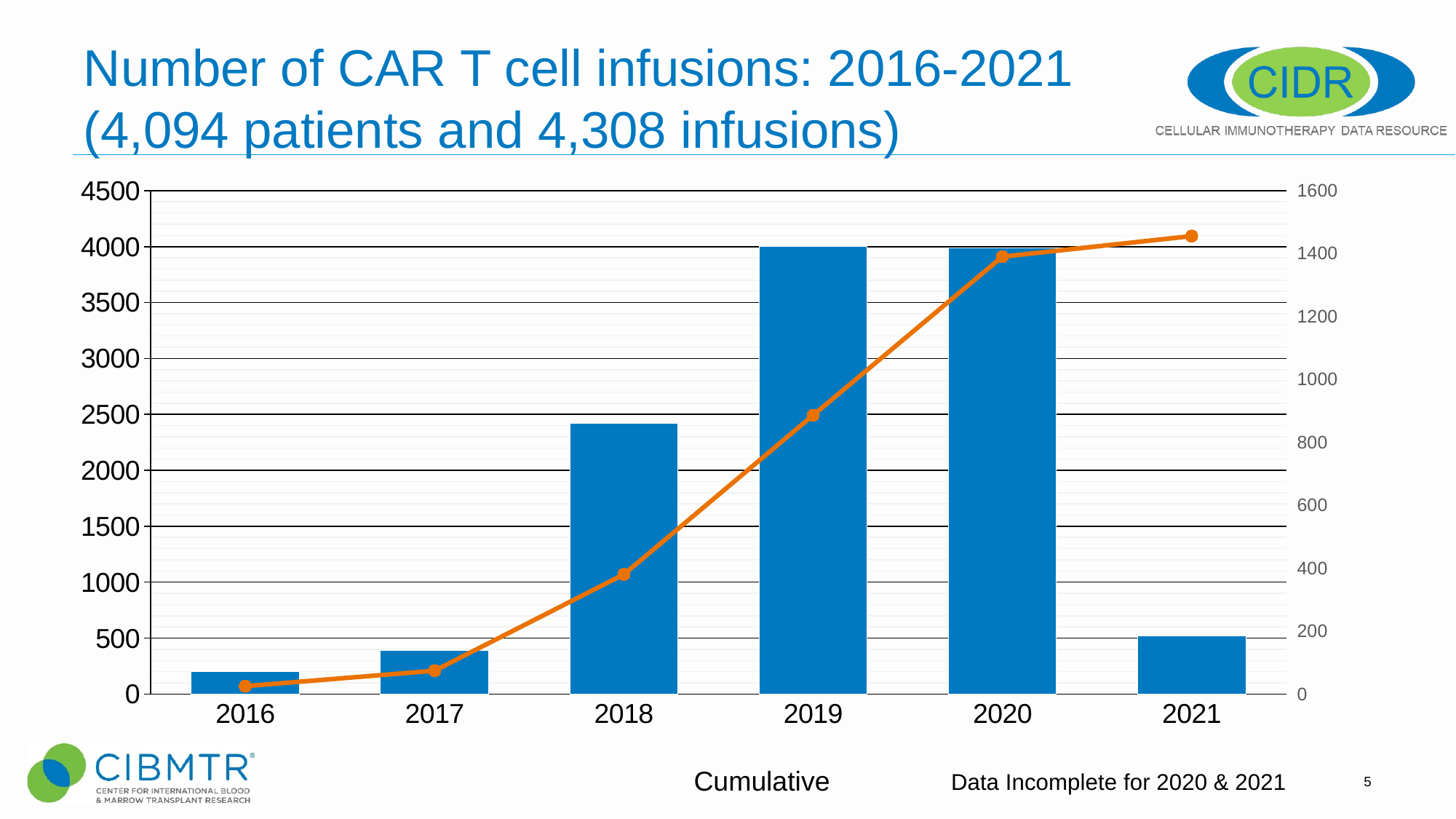
How many years are shown along the x axis of the chart? 6 Is the cumulative line point for 2020, read on the left axis, greater or less than 3500? greater According to the chart title, how many patients and infusions are covered? 4,094 patients and 4,308 infusions Is the cumulative line point for 2019, read on the left axis, greater or less than 2000? greater Which bar is taller, 2021 or 2019? 2019 What kind of chart is shown on the slide? A bar chart with a line overlay Which bar is taller, 2018 or 2017? 2018 Does the orange cumulative line rise or fall from 2016 to 2021? Rises Is the cumulative line point for 2017, read on the left axis, greater or less than 500? less Which year has the shortest bar in the chart? 2016 Which year has the highest point on the orange cumulative line? 2021